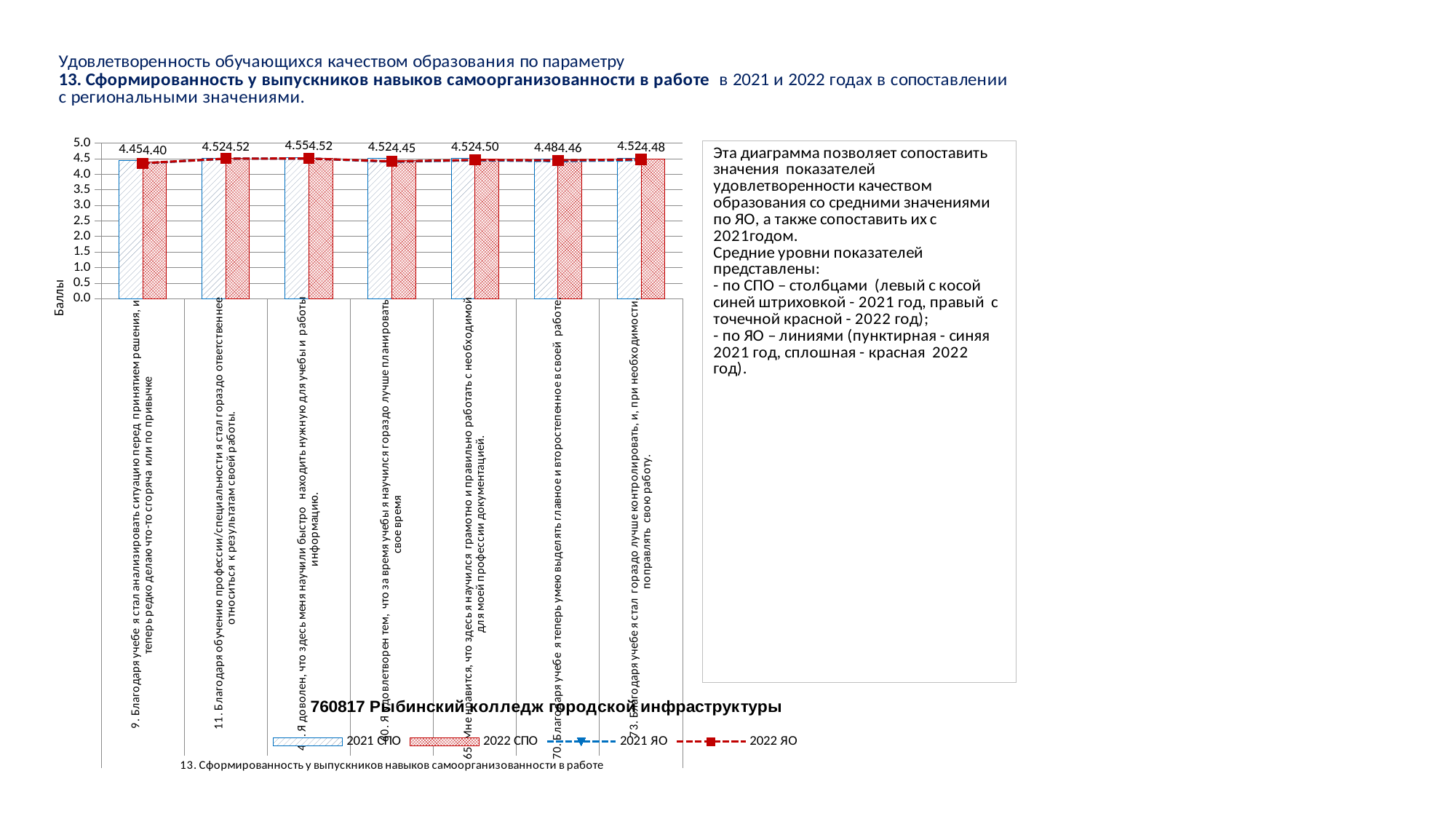
How many series does the chart legend list? 4 What is the 2022 СПО value for statement 20 (Я удовлетворен тем, что за время учебы я научился гораздо лучше планировать свое время)? 4.45 Which statement has the lowest 2022 СПО value? 9. Благодаря учебе я стал анализировать ситуацию перед принятием решения (4.40) For statement 73 (контролировать и поправлять свою работу), which is larger: the 2021 СПО value or the 2022 СПО value? 2021 СПО (4.52 vs 4.48) What kind of chart is shown on the slide? A bar chart combined with line series Which statement has the highest 2021 СПО value? Я доволен, что здесь меня научили быстро находить нужную для учебы и работы информацию (4.55) What is the 2021 СПО value for statement 70 (Благодаря учебе я теперь умею выделять главное и второстепенное в своей работе)? 4.48 What is the label of the vertical axis? Баллы What is the 2021 СПО value for statement 9 (Благодаря учебе я стал анализировать ситуацию перед принятием решения)? 4.45 What is the 2022 СПО value for statement 9 (Благодаря учебе я стал анализировать ситуацию перед принятием решения)? 4.40 How many categories (statements) are plotted along the x axis? 7 What is the difference between the 2021 СПО and 2022 СПО values for statement 20 (планировать свое время)? 0.07